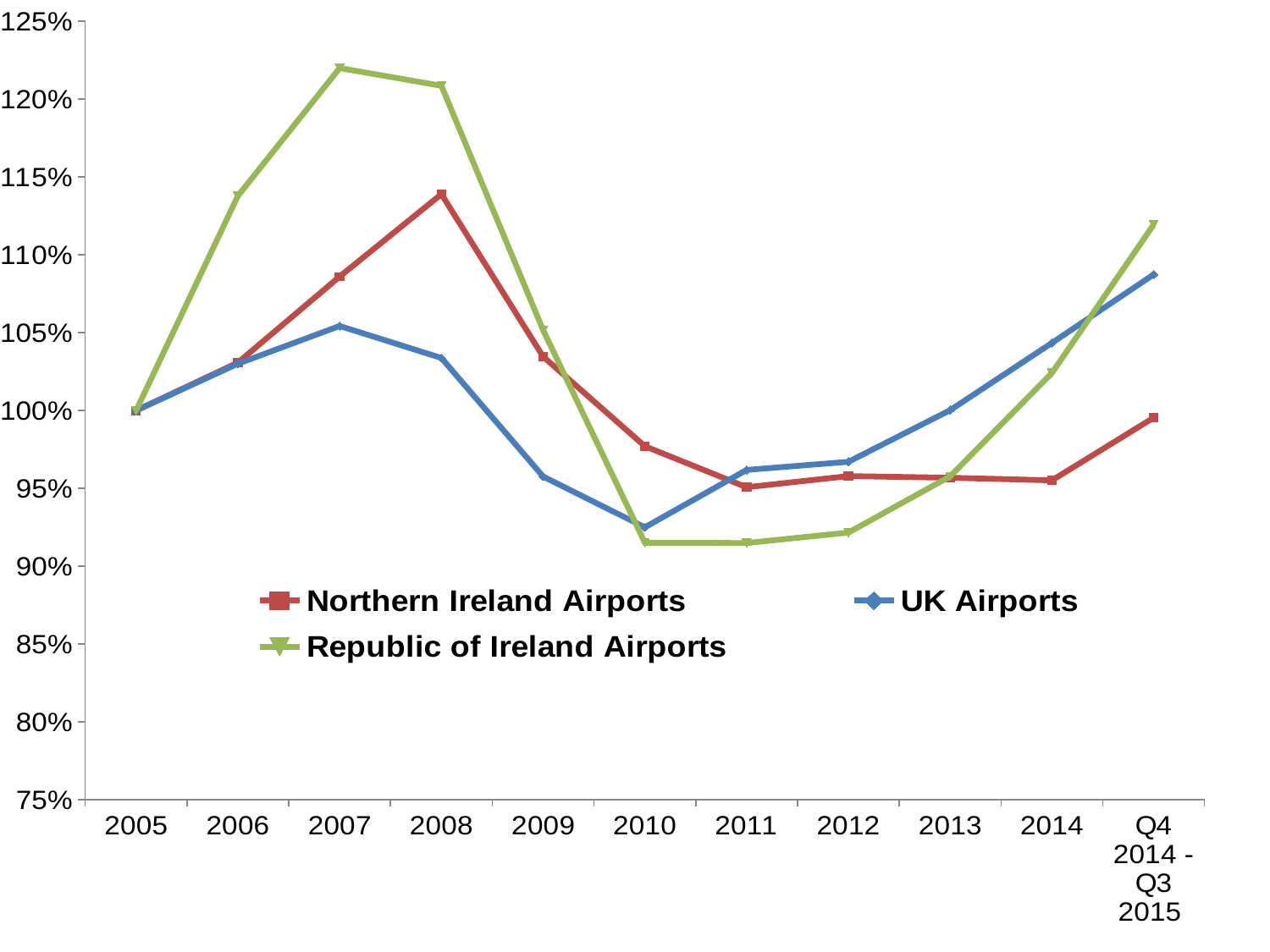
What is the value for Northern Ireland Airports in 2005? 100% Is the value for Republic of Ireland Airports in 2007 greater or less than 120%? greater How many series does the legend list? 3 How many points are plotted along the x axis for each series? 11 Is the value for Northern Ireland Airports in 2008 greater or less than 110%? greater What kind of chart is shown on the slide? line chart In which year does Northern Ireland Airports reach its highest value? 2008 In 2010, which is higher: Northern Ireland Airports or UK Airports? Northern Ireland Airports What is the value for UK Airports in 2013? 100% Is the value for UK Airports in 2010 greater or less than 95%? less Does the Republic of Ireland Airports line rise or fall from 2011 to Q4 2014 - Q3 2015? rise In which year does UK Airports reach its lowest value? 2010